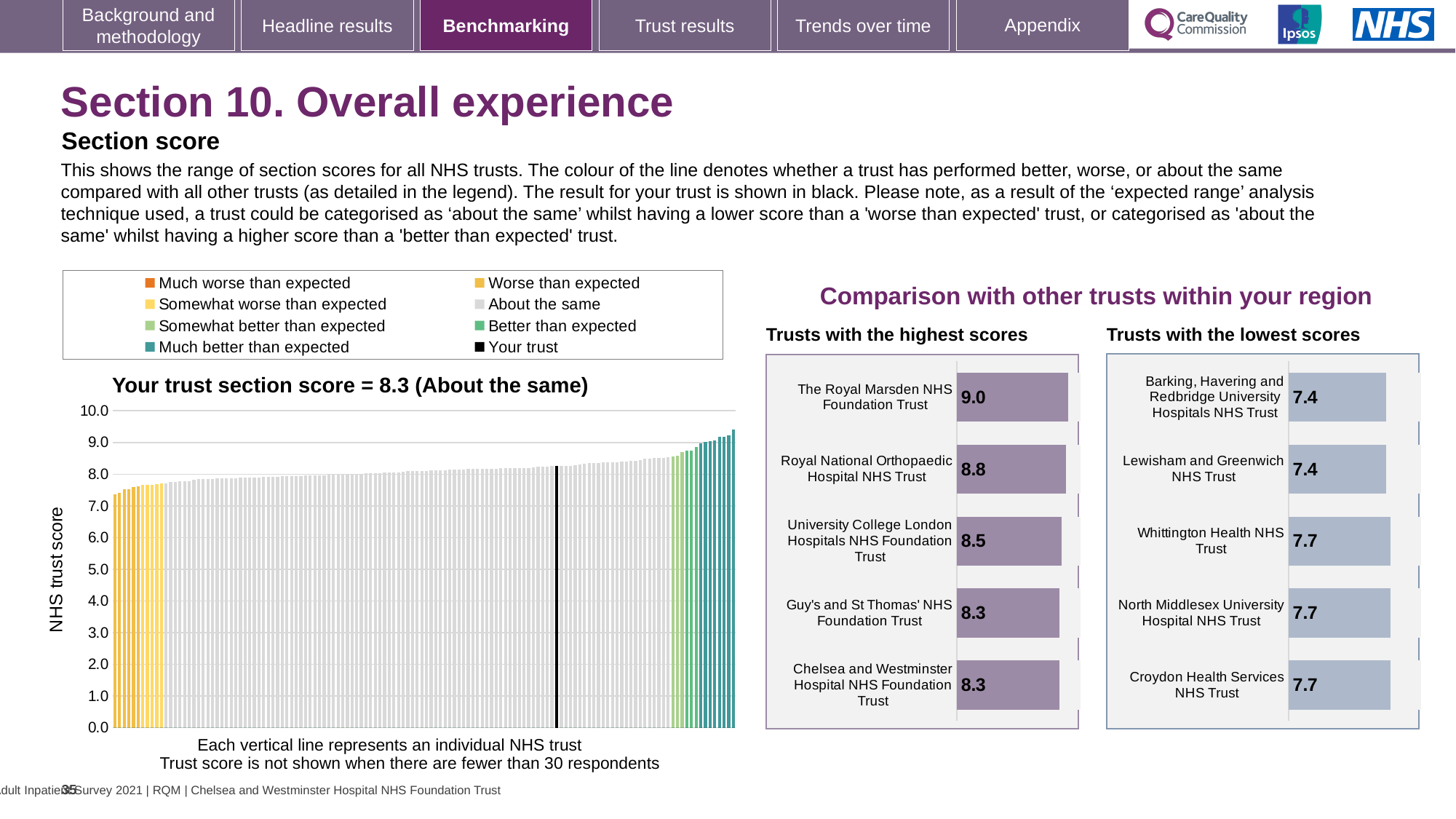
How many trusts are shown in the 'Trusts with the lowest scores' chart? 5 In the 'Trusts with the lowest scores' chart, what is the difference between the scores of Croydon Health Services NHS Trust and Barking, Havering and Redbridge University Hospitals NHS Trust? 0.3 In the 'Your trust section score' chart, do the trust scores rise or fall from left to right? Rise In the 'Trusts with the highest scores' chart, what is the score for University College London Hospitals NHS Foundation Trust? 8.5 In the 'Trusts with the lowest scores' chart, what is the score for Lewisham and Greenwich NHS Trust? 7.4 In the 'Trusts with the highest scores' chart, which trust has the highest score? The Royal Marsden NHS Foundation Trust In the 'Trusts with the highest scores' chart, what is the difference between the scores of The Royal Marsden NHS Foundation Trust and Royal National Orthopaedic Hospital NHS Trust? 0.2 How many entries does the legend of the 'Your trust section score' chart list? 8 In the 'Trusts with the highest scores' chart, which has the larger score: Royal National Orthopaedic Hospital NHS Trust or Guy's and St Thomas' NHS Foundation Trust? Royal National Orthopaedic Hospital NHS Trust In the 'Trusts with the highest scores' chart, what is the score for The Royal Marsden NHS Foundation Trust? 9.0 In the 'Trusts with the lowest scores' chart, what is the score for Whittington Health NHS Trust? 7.7 What type of chart is the 'Your trust section score' chart on the left? Bar chart